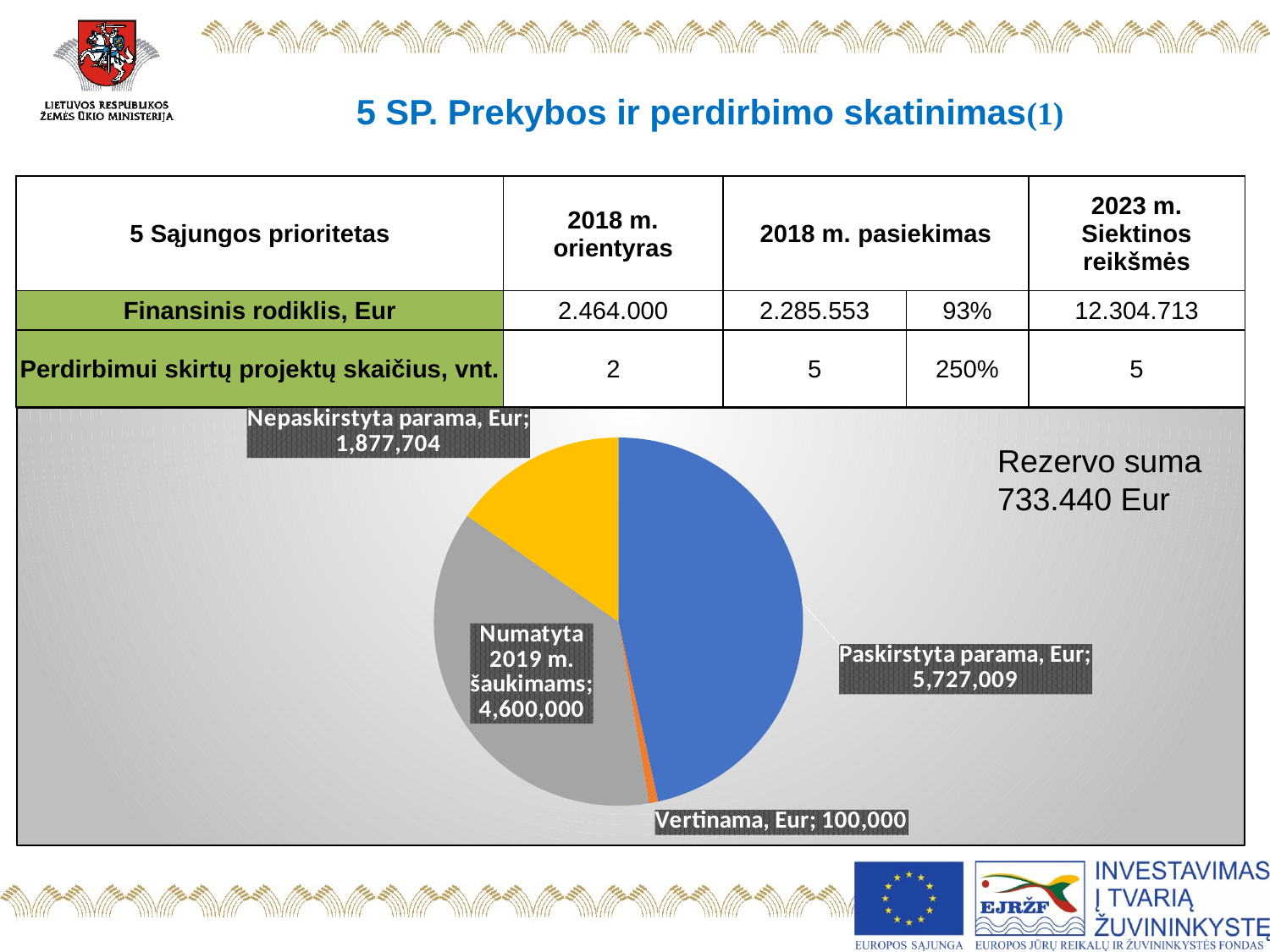
What is the value of the 'Vertinama, Eur' slice in the pie chart? 100,000 Which is larger in the pie chart: 'Numatyta 2019 m. šaukimams' or 'Nepaskirstyta parama, Eur'? Numatyta 2019 m. šaukimams Which slice of the pie chart is the smallest? Vertinama, Eur What is the difference between the 'Paskirstyta parama, Eur' and 'Numatyta 2019 m. šaukimams' values in the pie chart? 1,127,009 What is the total of all slices in the pie chart? 12,304,713 Which slice of the pie chart is the largest? Paskirstyta parama, Eur What is the value of the 'Nepaskirstyta parama, Eur' slice in the pie chart? 1,877,704 What type of chart is shown on the slide? Pie chart What is the value of the 'Paskirstyta parama, Eur' slice in the pie chart? 5,727,009 What is the value of the 'Numatyta 2019 m. šaukimams' slice in the pie chart? 4,600,000 What colour is the 'Paskirstyta parama, Eur' slice in the pie chart? Blue How many slices does the pie chart have? 4